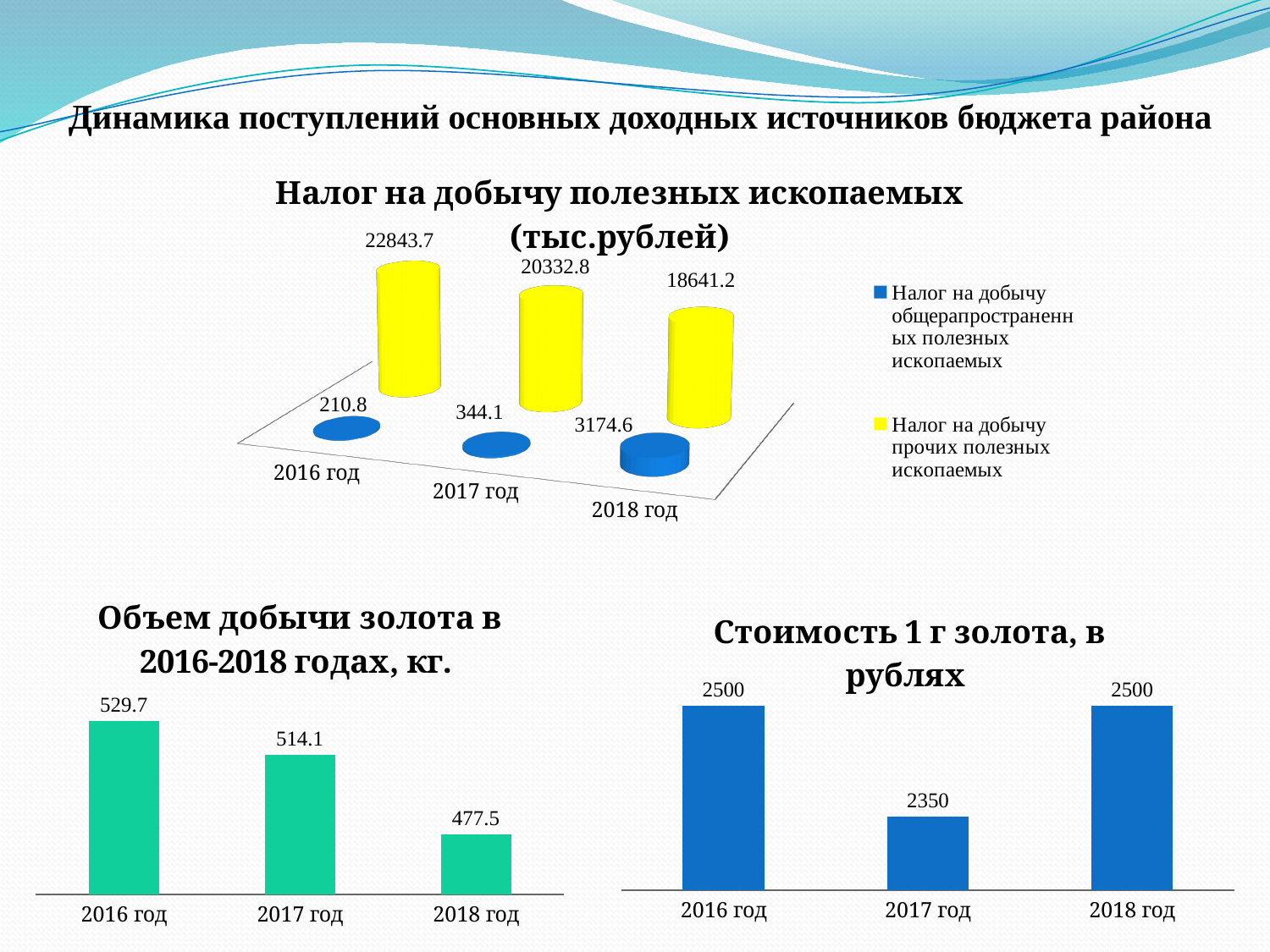
In the chart 'Налог на добычу полезных ископаемых (тыс.рублей)', what is the value for 'Налог на добычу прочих полезных ископаемых' in 2016 год? 22843.7 In the chart 'Налог на добычу полезных ископаемых (тыс.рублей)', how many series does the legend list? 2 In the chart 'Стоимость 1 г золота, в рублях', what is the value for 2017 год? 2350 In the chart 'Объем добычи золота в 2016-2018 годах, кг.', what is the value for 2017 год? 514.1 In the chart 'Налог на добычу полезных ископаемых (тыс.рублей)', what is the value for 'Налог на добычу общераспространенных полезных ископаемых' in 2018 год? 3174.6 In the chart 'Налог на добычу полезных ископаемых (тыс.рублей)', which year has the lowest value for 'Налог на добычу прочих полезных ископаемых'? 2018 год In the chart 'Налог на добычу полезных ископаемых (тыс.рублей)', what is the difference between the 2017 год and 2016 год values for 'Налог на добычу общераспространенных полезных ископаемых'? 133.3 In the chart 'Стоимость 1 г золота, в рублях', which is larger, the value for 2016 год or 2017 год? 2016 год In the chart 'Объем добычи золота в 2016-2018 годах, кг.', which year has the highest value? 2016 год In the chart 'Налог на добычу полезных ископаемых (тыс.рублей)', does the value for 'Налог на добычу прочих полезных ископаемых' rise or fall from 2016 год to 2018 год? fall What kind of chart is 'Объем добычи золота в 2016-2018 годах, кг.'? bar chart In the chart 'Объем добычи золота в 2016-2018 годах, кг.', what is the difference between the 2016 год and 2018 год values? 52.2